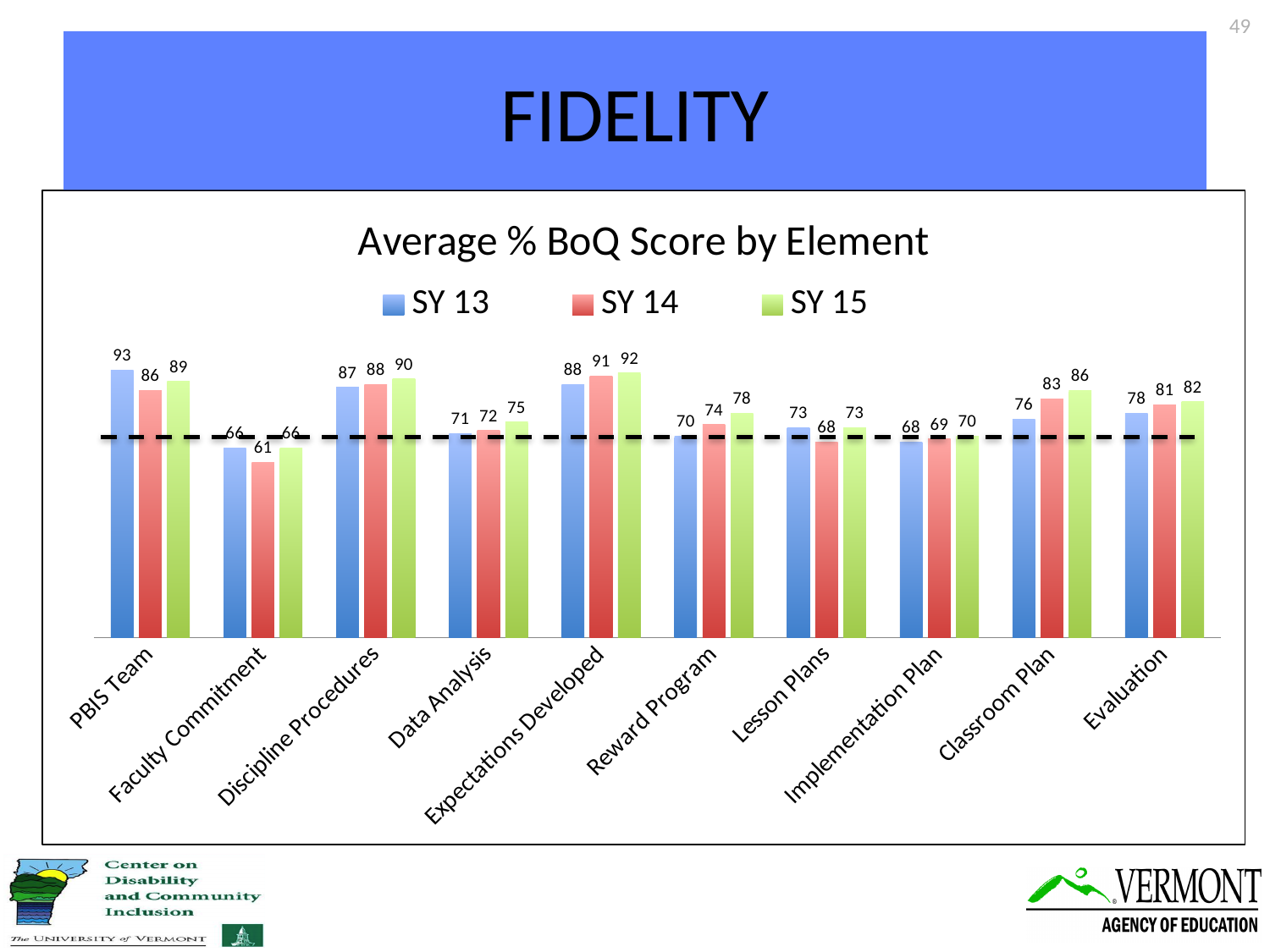
What is the difference between the SY 15 and SY 13 values for Reward Program? 8 What is the SY 14 value for Faculty Commitment? 61 What is the SY 15 value for Classroom Plan? 86 Which is larger for Lesson Plans, the SY 13 value or the SY 14 value? SY 13 How many elements are shown on the x axis? 10 What is the SY 13 value for PBIS Team? 93 Which element has the lowest SY 14 value? Faculty Commitment Which element has the highest SY 15 value? Expectations Developed What kind of chart is shown? bar chart What is the title of the chart? Average % BoQ Score by Element Do the values for Classroom Plan rise or fall from SY 13 to SY 15? rise How many series does the legend list? 3